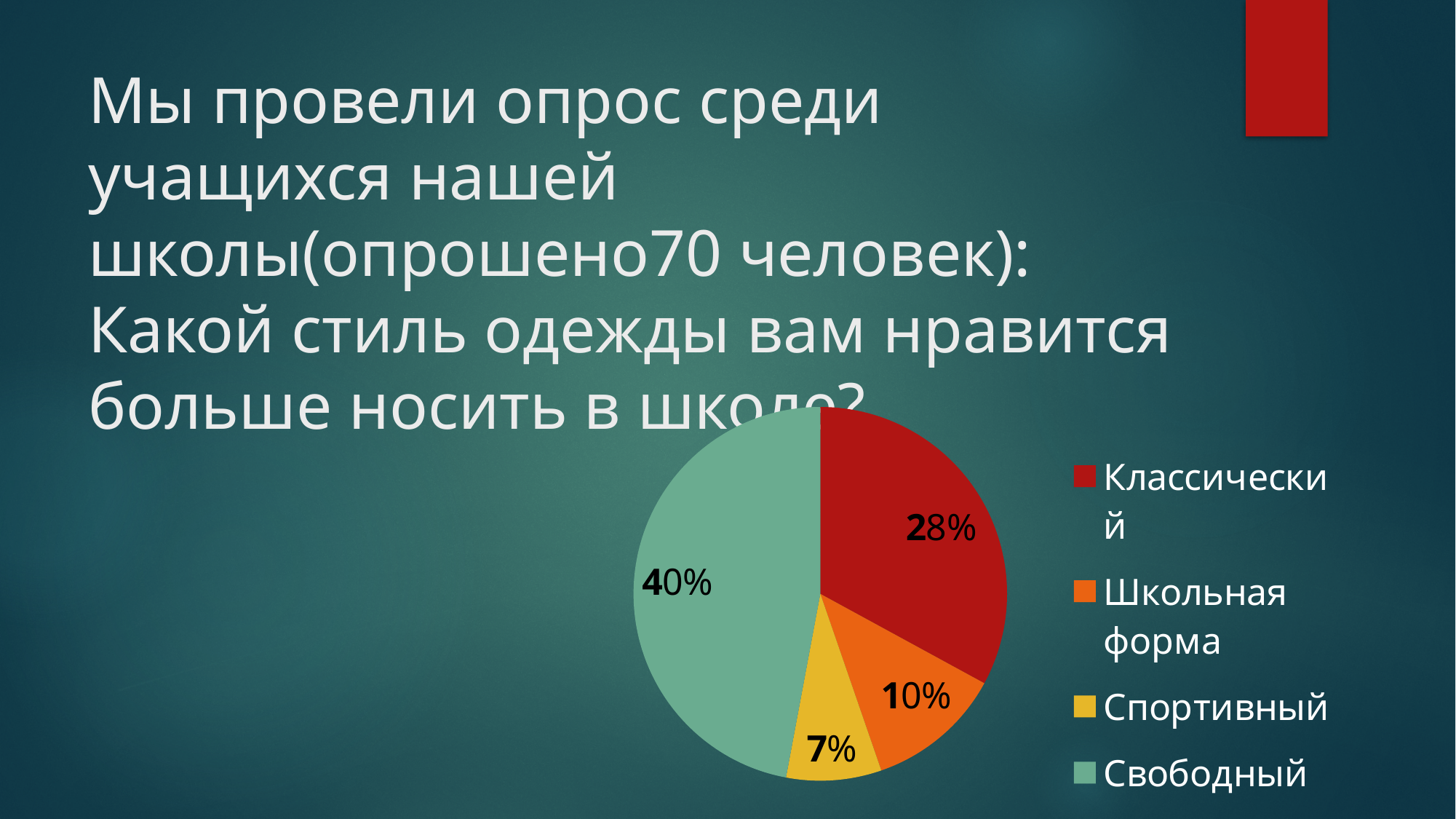
What is the difference between the Школьная форма and Спортивный percentages? 3% What kind of chart is shown on the slide? Pie chart What percentage is shown for the Школьная форма slice? 10% What share of the pie does the Свободный slice have? 40% Which category has the largest slice of the pie? Свободный What percentage is shown for the Классический slice? 28% Which is larger, the Классический slice or the Школьная форма slice? Классический What is the difference between the Свободный and Классический percentages? 12% What colour is the Свободный slice in the pie chart? Green What percentage is shown for the Спортивный slice? 7% Which category has the smallest slice of the pie? Спортивный How many categories does the pie chart have? 4